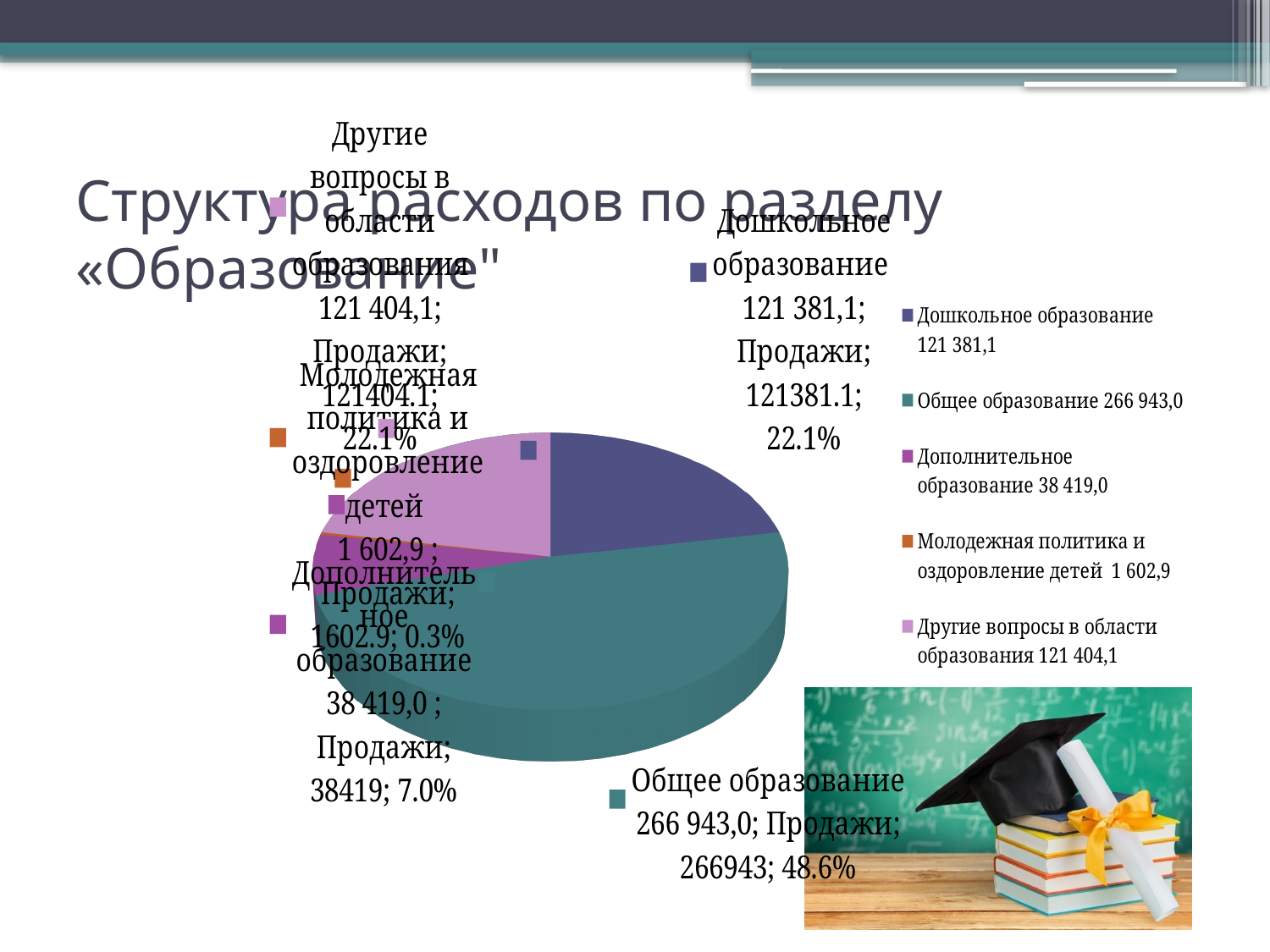
What is the difference between the values for Общее образование (266943) and Дополнительное образование (38419) as printed in the data labels? 228524 Which category has the smallest share of the pie? Молодежная политика и оздоровление детей What kind of chart is shown on the slide? pie chart Which is larger, the value for Общее образование or the value for Дополнительное образование? Общее образование Which category has the largest share of the pie? Общее образование What series name appears in the data labels of the pie chart? Продажи What percentage share does Общее образование have? 48.6% How many slices does the pie chart have? 5 What percentage share does Дополнительное образование have? 7.0% What value is shown for Другие вопросы в области образования in the legend? 121 404,1 What value is shown for Дошкольное образование in the legend? 121 381,1 What percentage share does Молодежная политика и оздоровление детей have? 0.3%